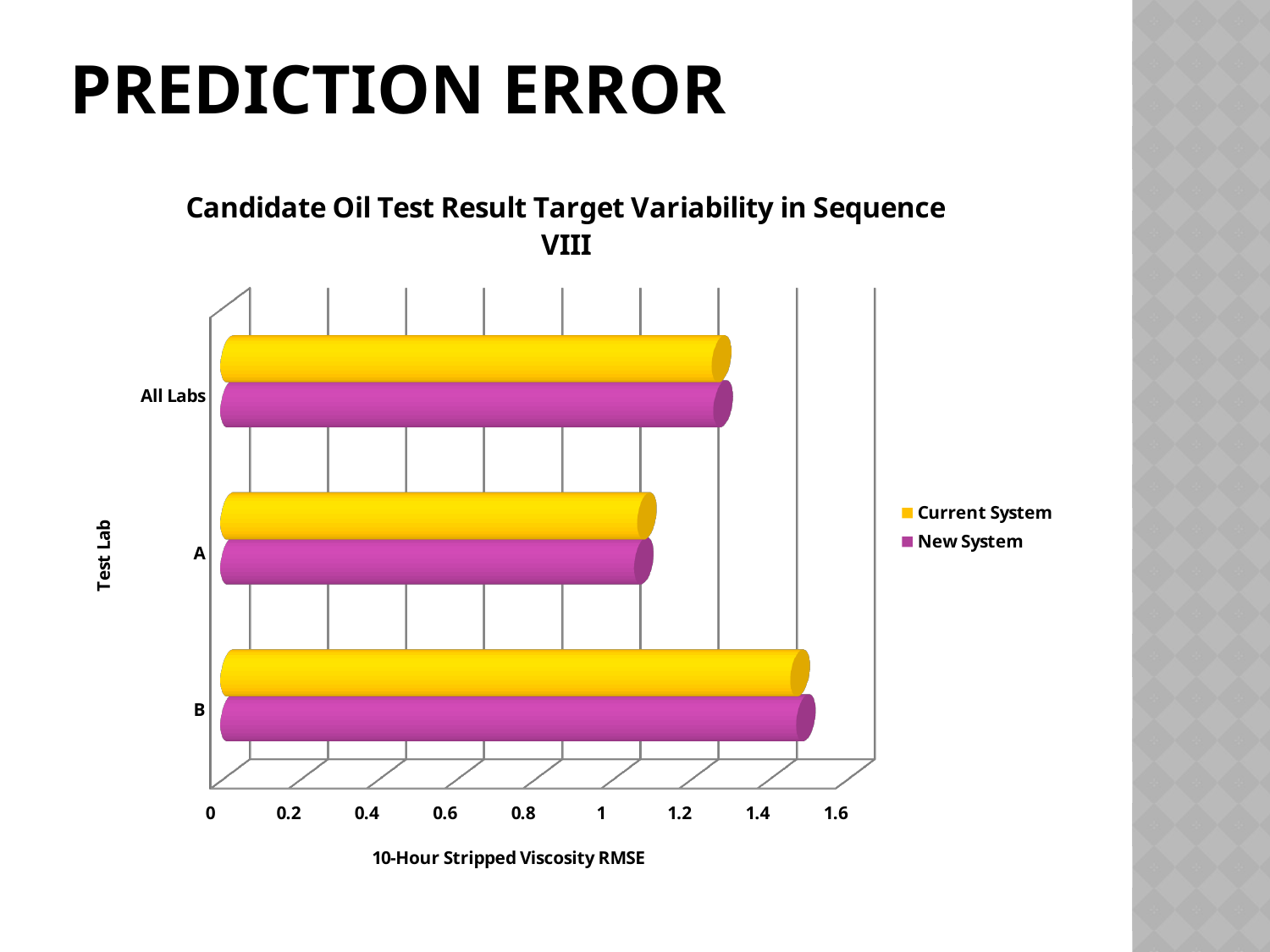
Is the Current System value for A greater or less than 1.2? less Which test lab has the highest Current System value? B Is the Current System value for B greater or less than 1.4? greater Is the New System value for A greater or less than 1? greater How many series does the legend list? 2 Which series is shown in purple? New System Which test lab has the lowest New System value? A What is the label of the horizontal axis? 10-Hour Stripped Viscosity RMSE What kind of chart is shown on the slide? bar chart How many test lab categories are shown on the chart? 3 For the New System series, which is larger: the value for B or the value for A? B